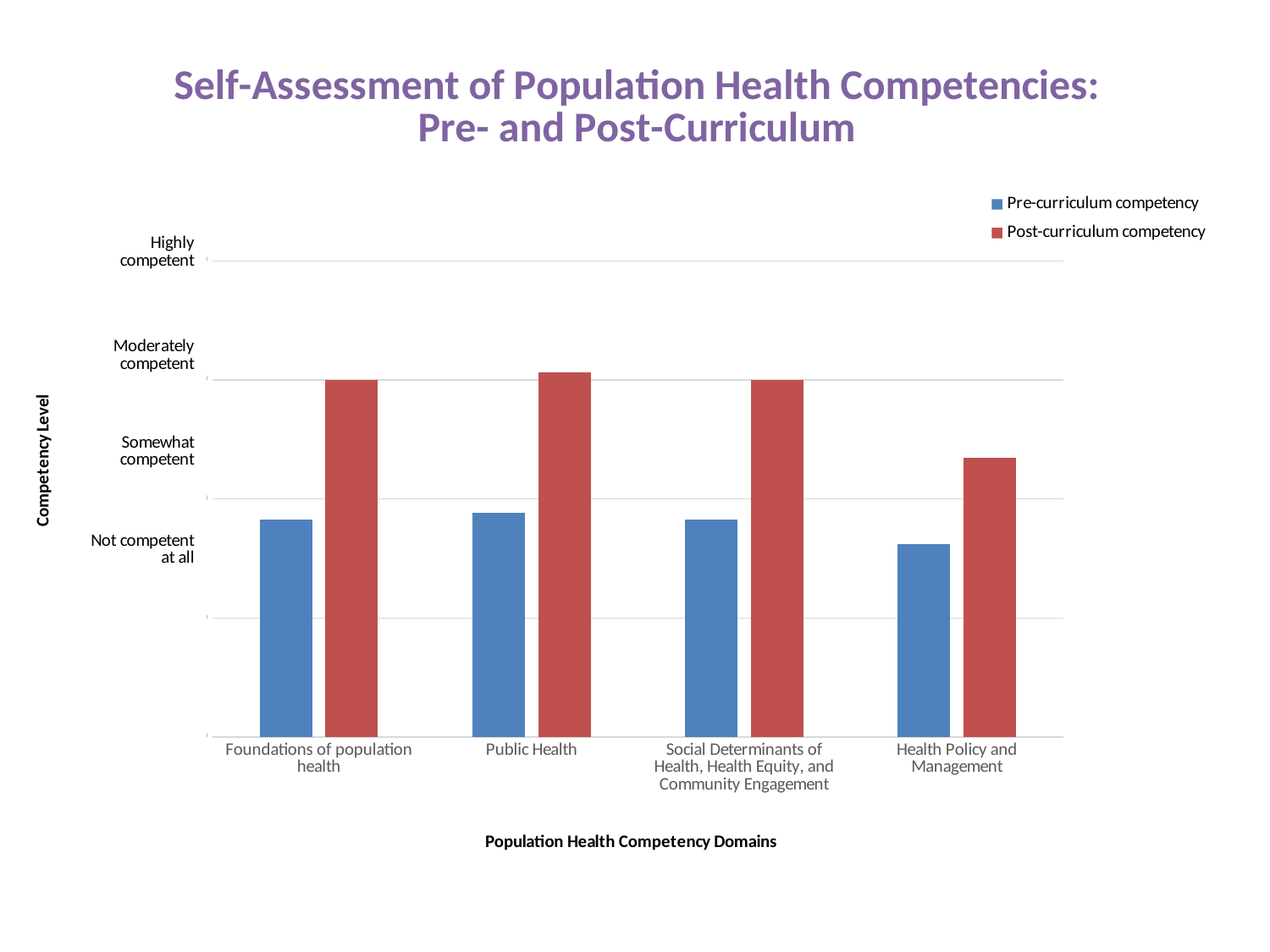
For Social Determinants of Health, Health Equity, and Community Engagement, is the pre-curriculum or post-curriculum competency higher? Post-curriculum competency Which domain has the lowest post-curriculum competency? Health Policy and Management How many competency domains are shown on the x axis? 4 Which domain has the lowest pre-curriculum competency? Health Policy and Management What is the title of the chart? Self-Assessment of Population Health Competencies: Pre- and Post-Curriculum For Public Health, which is larger: pre-curriculum competency or post-curriculum competency? Post-curriculum competency Which is larger: the pre-curriculum competency for Public Health or for Health Policy and Management? Public Health What kind of chart is shown on the slide? Bar chart How many series does the legend list? 2 What is the label on the vertical axis? Competency Level